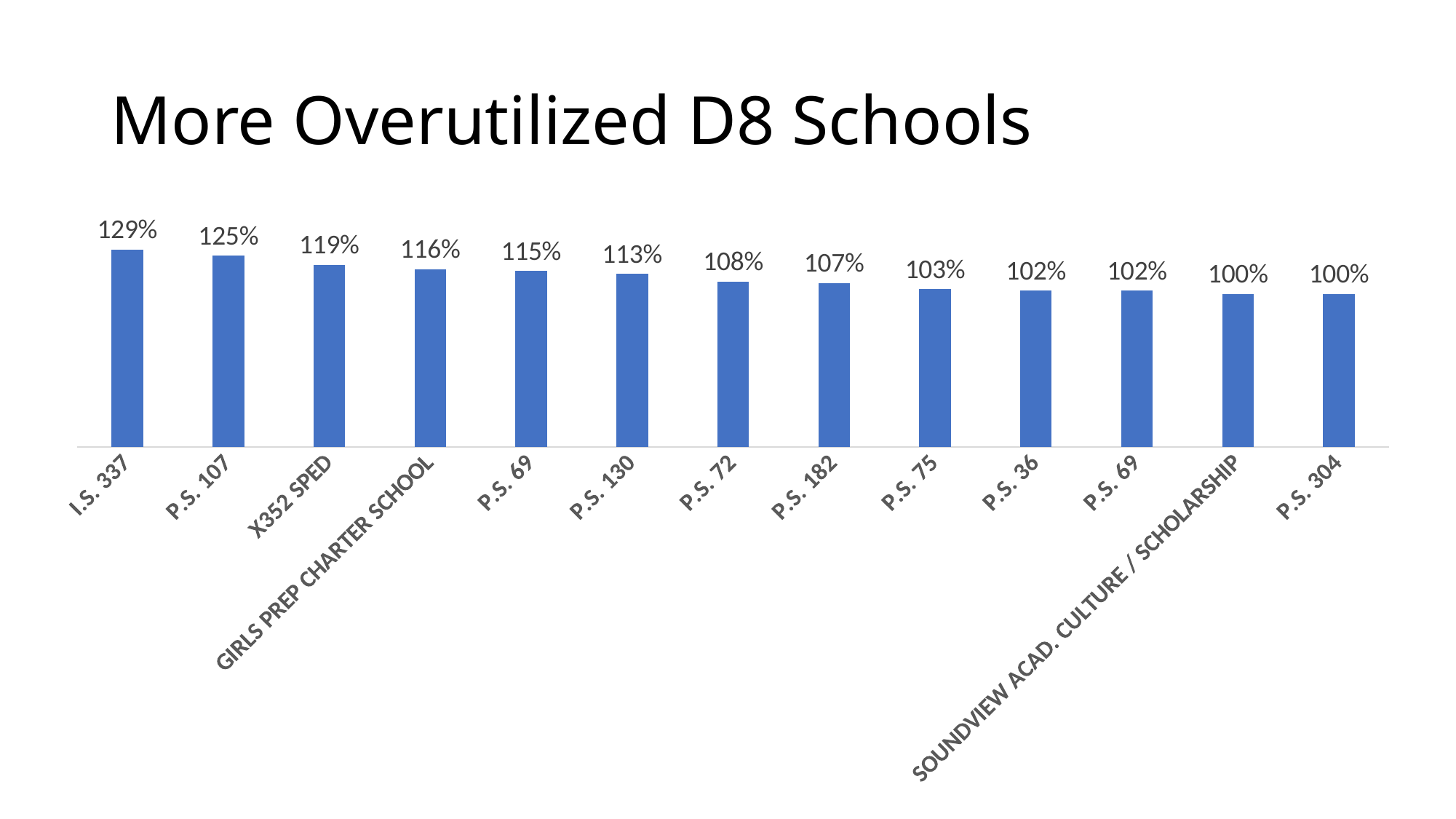
How many schools are shown in the chart? 13 What is the difference between the values for P.S. 130 and P.S. 304? 13% Which is larger, the value for P.S. 72 or the value for P.S. 75? P.S. 72 What is the difference between the values for I.S. 337 and P.S. 107? 4% Do the values rise or fall from left to right along the x axis? Fall What is the value for I.S. 337? 129% What is the value for P.S. 182? 107% What kind of chart is shown on the slide? Bar chart What is the value for GIRLS PREP CHARTER SCHOOL? 116% Which school has the highest value? I.S. 337 What is the value for X352 SPED? 119% What is the value for SOUNDVIEW ACAD. CULTURE / SCHOLARSHIP? 100%